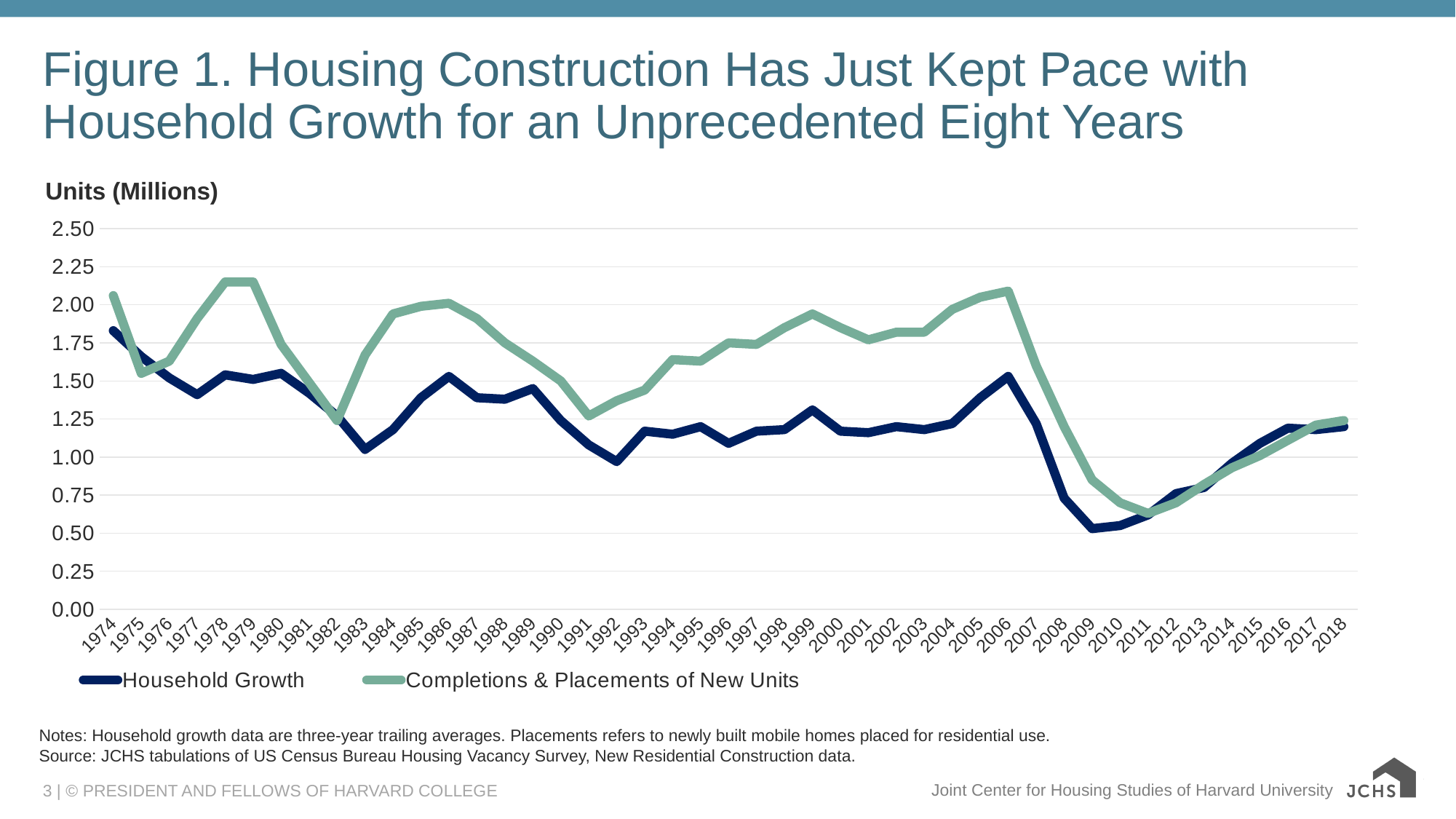
Is the value for Completions & Placements of New Units in 1978 greater or less than 2.00? greater Is the value for Household Growth in 2009 greater or less than 0.75? less How many series does the legend list? 2 Is the value for Household Growth in 2006 greater or less than 1.25? greater In which year is Household Growth at its lowest? 2009 In 1984, which series has the higher value: Household Growth or Completions & Placements of New Units? Completions & Placements of New Units What type of chart is shown on the slide? line chart In 1991, which series has the higher value: Household Growth or Completions & Placements of New Units? Completions & Placements of New Units How many years are plotted along the x axis? 45 Does Household Growth rise or fall from 2006 to 2009? fall In which year is Household Growth at its highest? 1974